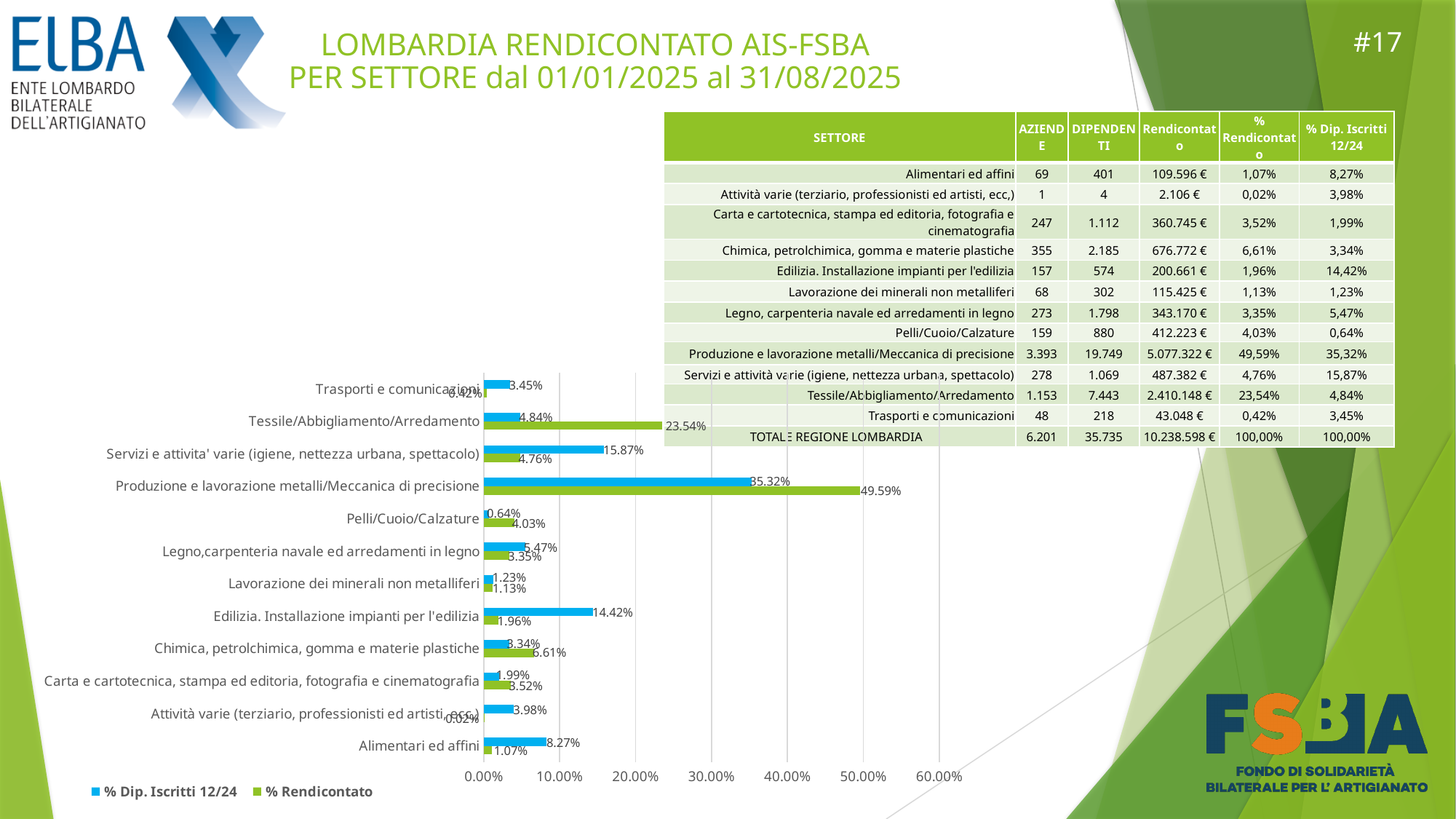
What kind of chart is shown on the slide? bar chart How many series does the chart legend list? 2 What is the % Dip. Iscritti 12/24 value for Alimentari ed affini in the chart? 8.27% For Servizi e attivita' varie (igiene, nettezza urbana, spettacolo), which is larger: % Dip. Iscritti 12/24 or % Rendicontato? % Dip. Iscritti 12/24 Which colour represents the % Rendicontato series in the chart? green What is the % Dip. Iscritti 12/24 value for Edilizia. Installazione impianti per l'edilizia in the chart? 14.42% Which sector has the lowest % Rendicontato in the chart? Attività varie (terziario, professionisti ed artisti, ecc.) What is the % Rendicontato value for Tessile/Abbigliamento/Arredamento in the chart? 23.54% What is the difference between the % Rendicontato and the % Dip. Iscritti 12/24 values for Produzione e lavorazione metalli/Meccanica di precisione? 14.27% Which sector has the highest % Rendicontato in the chart? Produzione e lavorazione metalli/Meccanica di precisione Is the % Rendicontato value for Produzione e lavorazione metalli/Meccanica di precisione greater or less than 40.00%? greater How many sector categories are plotted in the chart? 12